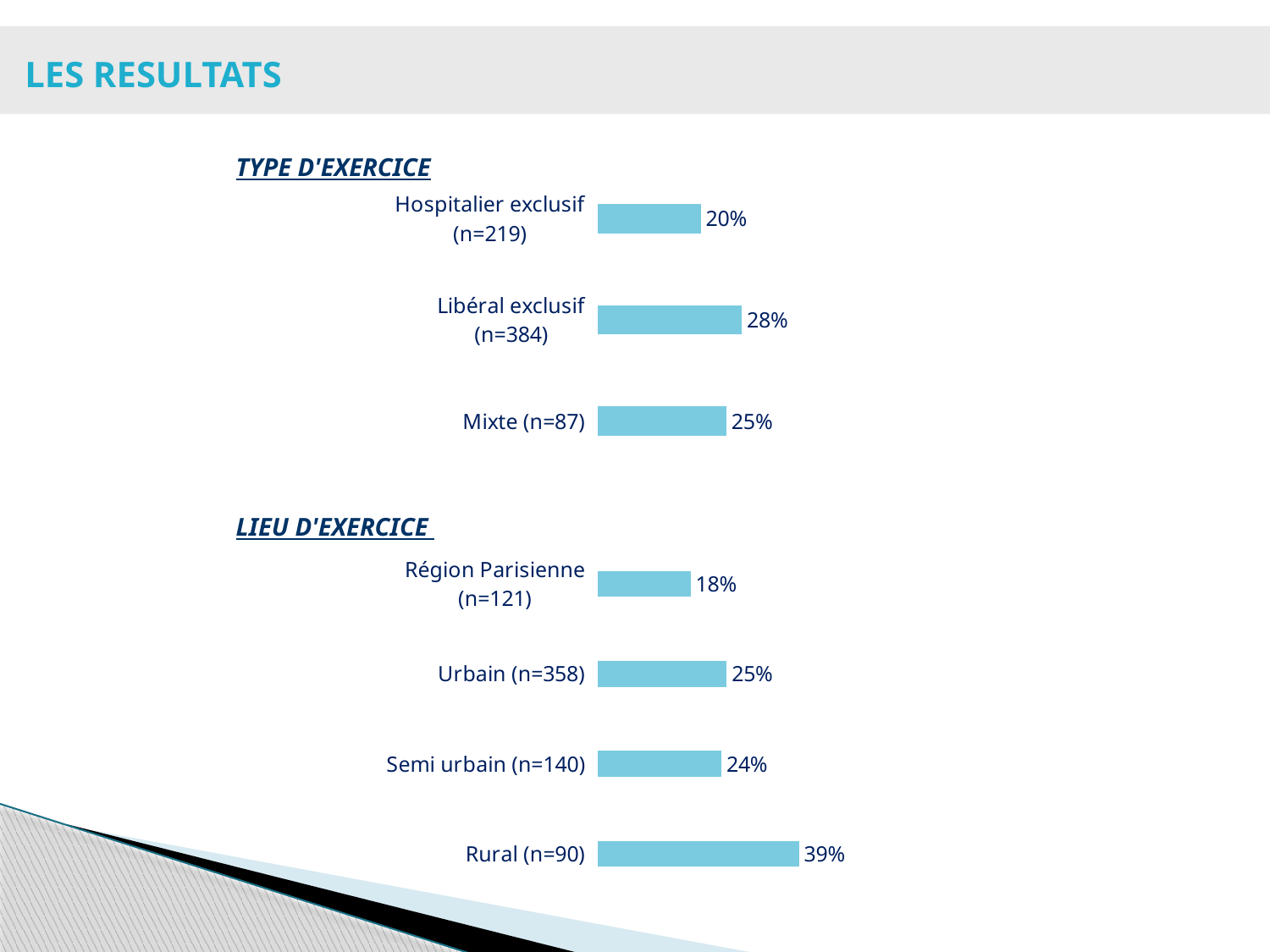
In the LIEU D'EXERCICE chart, what is the value for Semi urbain (n=140)? 24% In the TYPE D'EXERCICE chart, what is the value for Hospitalier exclusif (n=219)? 20% In the LIEU D'EXERCICE chart, what is the value for Rural (n=90)? 39% In the TYPE D'EXERCICE chart, how many categories are shown? 3 In the LIEU D'EXERCICE chart, which category has the lowest value? Région Parisienne (n=121) In the LIEU D'EXERCICE chart, which is larger, Urbain (n=358) or Région Parisienne (n=121)? Urbain (n=358) In the TYPE D'EXERCICE chart, which category has the highest value? Libéral exclusif (n=384) In the TYPE D'EXERCICE chart, what is the difference between Libéral exclusif and Hospitalier exclusif? 8% In the TYPE D'EXERCICE chart, which category has the lowest value? Hospitalier exclusif (n=219) In the TYPE D'EXERCICE chart, what is the value for Libéral exclusif (n=384)? 28% What kind of chart is the LIEU D'EXERCICE chart? Bar chart In the LIEU D'EXERCICE chart, what is the difference between Rural and Urbain? 14%